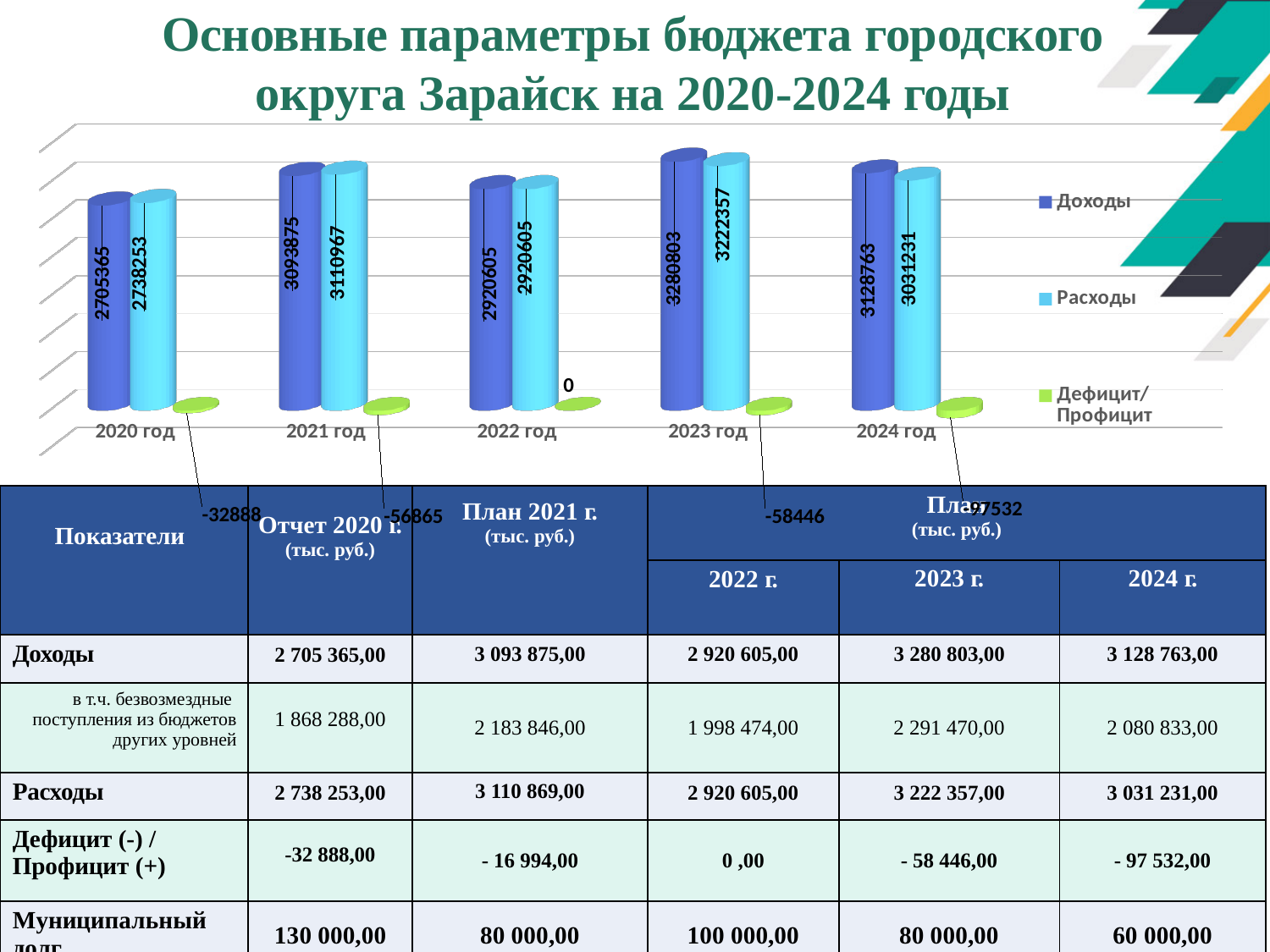
What is the value of Доходы for 2020 год in the chart? 2705365 What colour are the Расходы bars in the chart? light blue What is the value of Доходы for 2023 год in the chart? 3280803 What kind of chart is shown on the slide? bar chart How many series does the chart legend list? 3 What is the value of Дефицит/Профицит for 2022 год in the chart? 0 What is the value of Расходы for 2023 год in the chart? 3222357 How many year categories are shown on the x axis of the chart? 5 In which year is Доходы lowest in the chart? 2020 год In which year is Доходы highest in the chart? 2023 год For 2024 год, which is larger in the chart: Доходы or Расходы? Доходы What is the difference between Доходы and Расходы for 2023 год in the chart? 58446